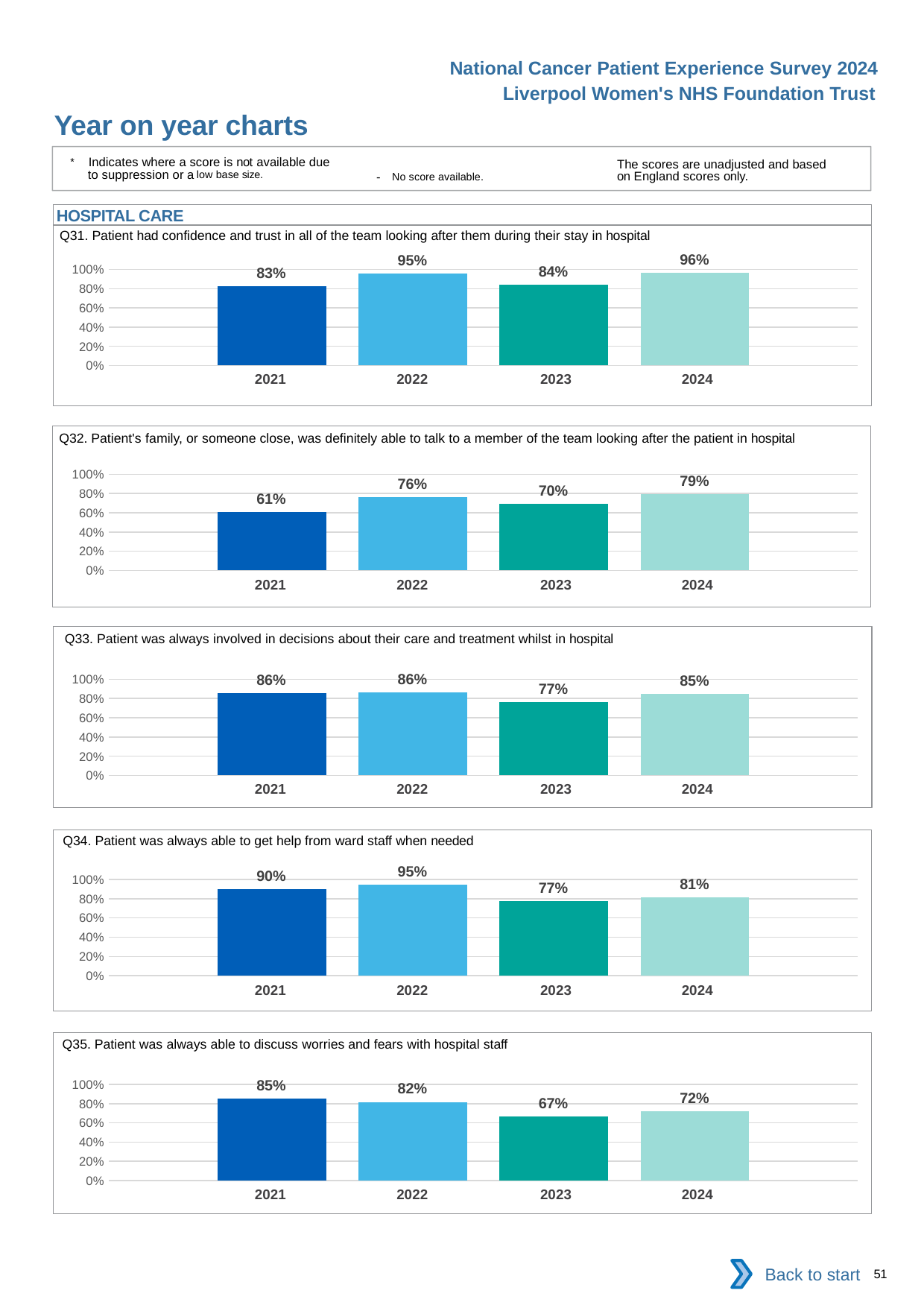
In the Q35 chart (patient was always able to discuss worries and fears), what is the value for 2023? 67% In the Q35 chart (patient was always able to discuss worries and fears), which is larger, the 2021 value or the 2024 value? 2021 How many years are plotted in the Q31 chart (patient had confidence and trust in all of the team)? 4 In the Q34 chart (patient was always able to get help from ward staff), what is the difference between the 2021 and 2024 values? 9 percentage points In the Q31 chart (patient had confidence and trust in all of the team), what is the value for 2024? 96% How many charts are shown on the slide? 5 What kind of chart is the Q32 chart (patient's family was definitely able to talk to a member of the team)? Bar chart In the Q32 chart (patient's family was definitely able to talk to a member of the team), which year has the lowest value? 2021 In the Q32 chart (patient's family was definitely able to talk to a member of the team), what is the value for 2022? 76% In the Q34 chart (patient was always able to get help from ward staff), which year has the highest value? 2022 In the Q33 chart (patient was always involved in decisions about their care), which year has the lowest value? 2023 In the Q33 chart (patient was always involved in decisions about their care), what is the difference between the 2022 and 2023 values? 9 percentage points